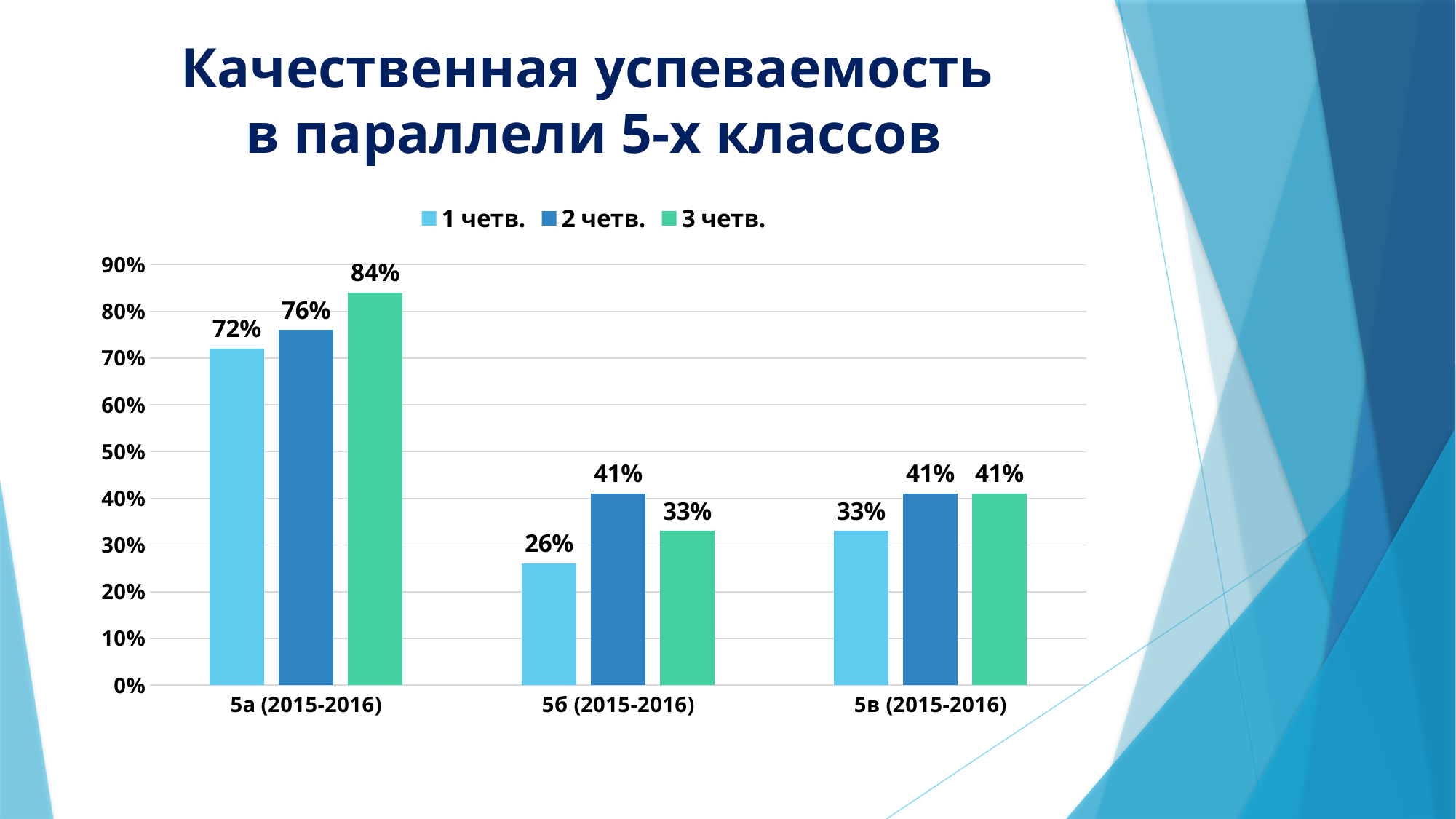
What is the value for 5а (2015-2016) in 3 четв.? 84% How many series does the legend list? 3 What is the difference between the 2 четв. values for 5а (2015-2016) and 5б (2015-2016)? 35% Which class has the highest value in 3 четв.? 5а (2015-2016) Which class has the lowest value in 1 четв.? 5б (2015-2016) What is the difference between the 3 четв. and 1 четв. values for 5а (2015-2016)? 12% What is the value for 5б (2015-2016) in 1 четв.? 26% What is the value for 5в (2015-2016) in 2 четв.? 41% How many classes are shown on the x axis? 3 Which is larger: the 1 четв. value for 5б (2015-2016) or the 1 четв. value for 5в (2015-2016)? 5в (2015-2016) Do the values for 5а (2015-2016) rise or fall from 1 четв. to 3 четв.? Rise What kind of chart is shown on the slide? Bar chart